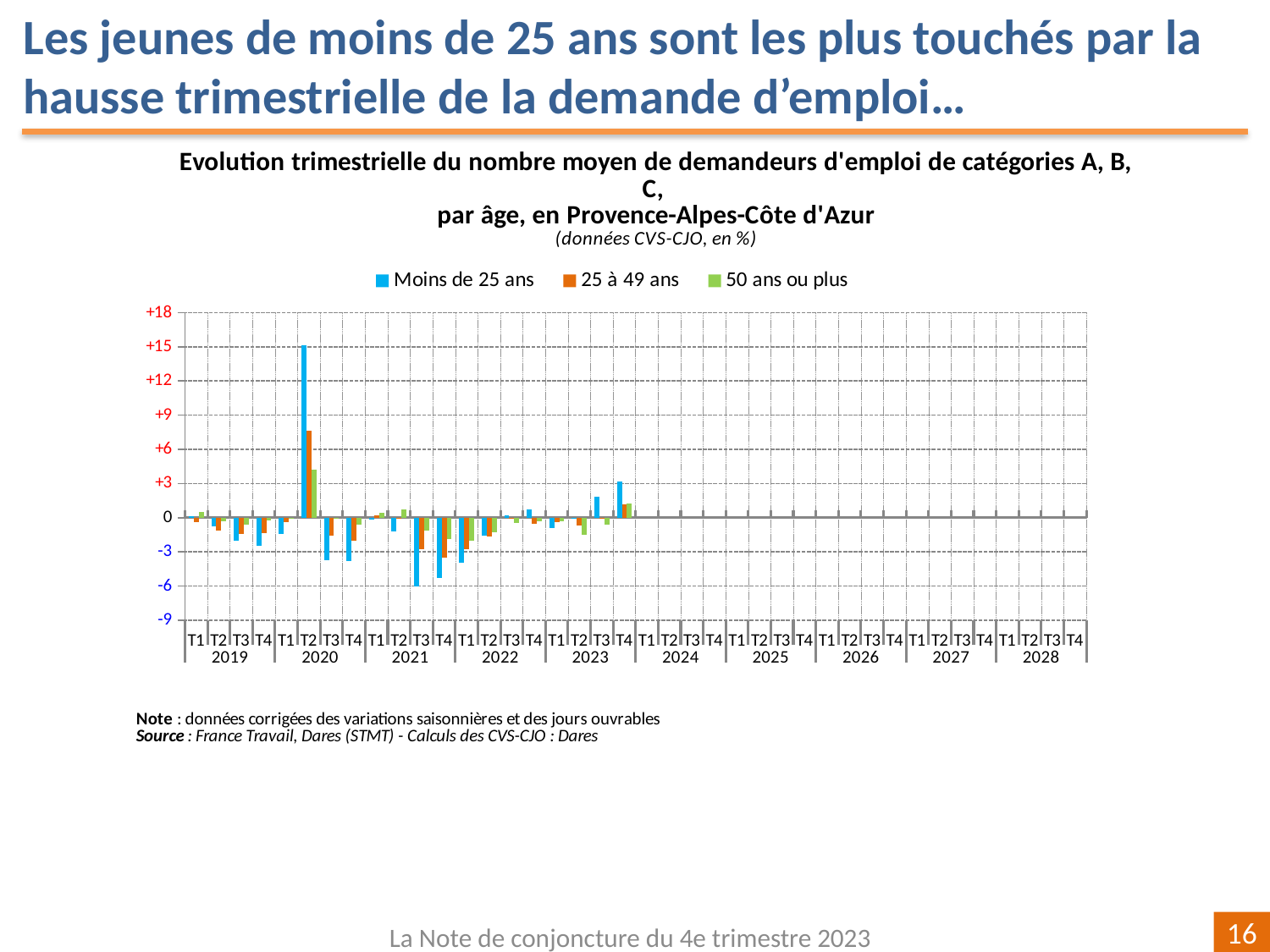
Is the value for '50 ans ou plus' in T2 2020 greater or less than +6? less Is the value for '25 à 49 ans' in T2 2020 greater or less than +6? greater In which quarter does the 'Moins de 25 ans' series reach its highest value? T2 2020 How many series does the legend list? 3 What kind of chart is shown on the slide? bar chart Is the value for 'Moins de 25 ans' in T2 2020 greater or less than +12? greater How many years are labelled along the x axis? 10 Which series are listed in the legend? Moins de 25 ans, 25 à 49 ans, 50 ans ou plus In T2 2020, which is larger: the value for 'Moins de 25 ans' or the value for '25 à 49 ans'? Moins de 25 ans What colour represents the 'Moins de 25 ans' series? blue